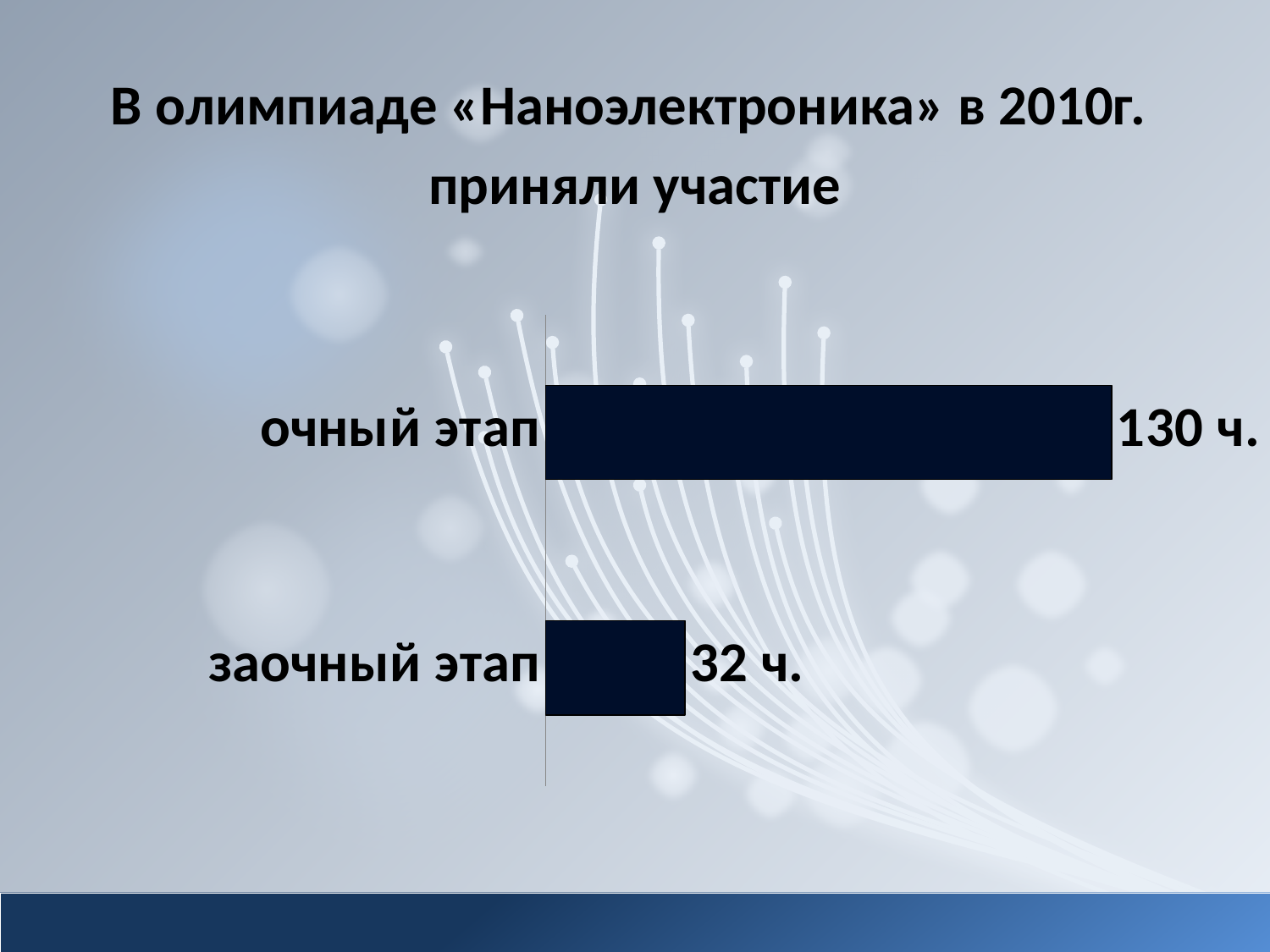
What is the difference between the values for очный этап and заочный этап? 98 ч. Are the bars in the chart horizontal or vertical? horizontal Which is larger, the value for очный этап or for заочный этап? очный этап What kind of chart is shown on the slide? bar chart How many categories are shown in the chart? 2 What is the value for заочный этап? 32 ч. Which category has the lowest value? заочный этап Which category has the highest value? очный этап What is the value for очный этап? 130 ч. What is the title of the slide containing the chart? В олимпиаде «Наноэлектроника» в 2010г. приняли участие What is the total of the two values shown in the chart? 162 ч.